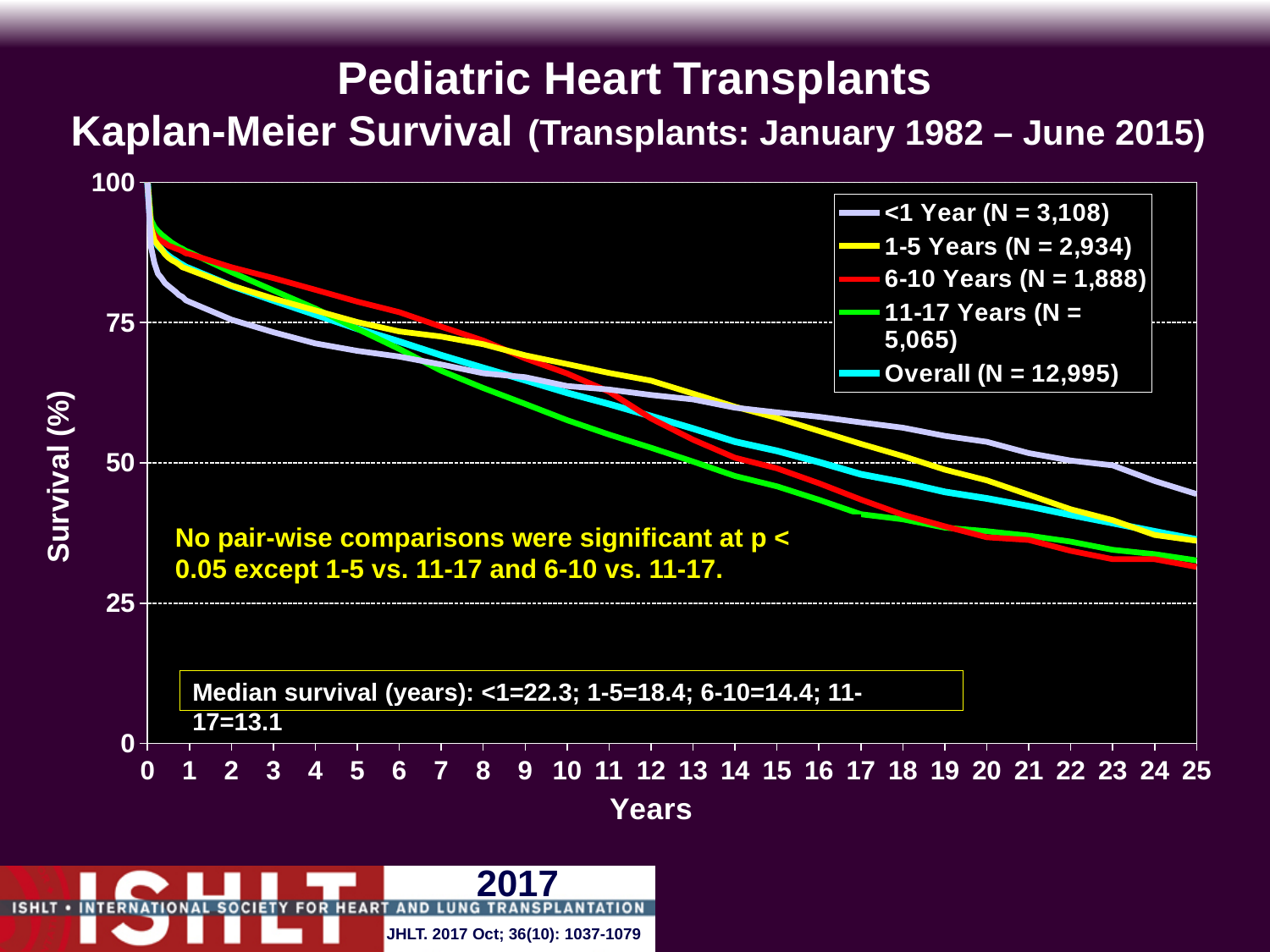
Is the survival value for the 11-17 Years group at 17 years greater or less than 50? less Do the survival curves rise or fall as years increase? fall What is the N for the Overall group shown in the legend? 12,995 Is the survival value for the <1 Year group at 25 years greater or less than 25? greater What is the median survival in years for the <1 age group? 22.3 What is the N for the <1 Year group shown in the legend? 3,108 What is the median survival in years for the 6-10 age group? 14.4 At 20 years, which is larger: survival for <1 Year or for 11-17 Years? <1 Year Which series has the highest survival at 25 years? <1 Year What kind of chart is shown on the slide? line chart How many series does the legend list? 5 Which age group has the lowest median survival according to the text box? 11-17